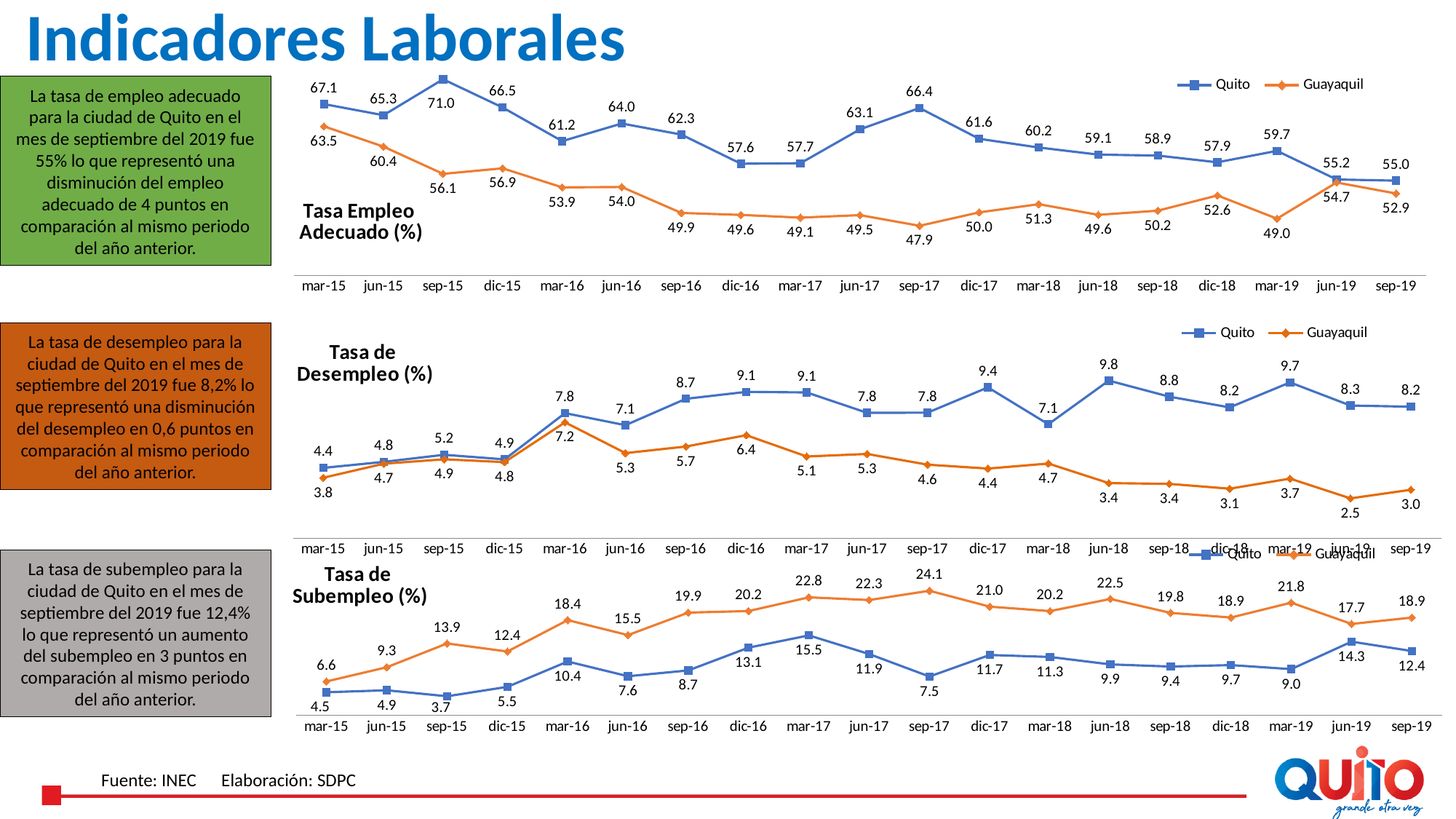
In the Tasa Empleo Adecuado (%) chart, which period has the highest value for Quito? sep-15 In the Tasa de Desempleo (%) chart, what is the value for Guayaquil in jun-19? 2.5 In the Tasa de Subempleo (%) chart, what is the value for Guayaquil in sep-17? 24.1 In the Tasa Empleo Adecuado (%) chart, which period has the lowest value for Guayaquil? sep-17 In the Tasa de Subempleo (%) chart, which period has the lowest value for Quito? sep-15 How many periods are plotted on the x axis of the Tasa de Subempleo (%) chart? 19 In the Tasa de Subempleo (%) chart, what is the difference between Guayaquil and Quito in sep-19? 6.5 In the Tasa Empleo Adecuado (%) chart, what is the value for Quito in sep-19? 55.0 In the Tasa Empleo Adecuado (%) chart, what is the difference between Quito and Guayaquil in mar-15? 3.6 What type of chart is the Tasa Empleo Adecuado (%) chart? Line chart In the Tasa de Desempleo (%) chart, which is larger in dic-16: Quito or Guayaquil? Quito In the Tasa de Desempleo (%) chart, which period has the highest value for Quito? jun-18